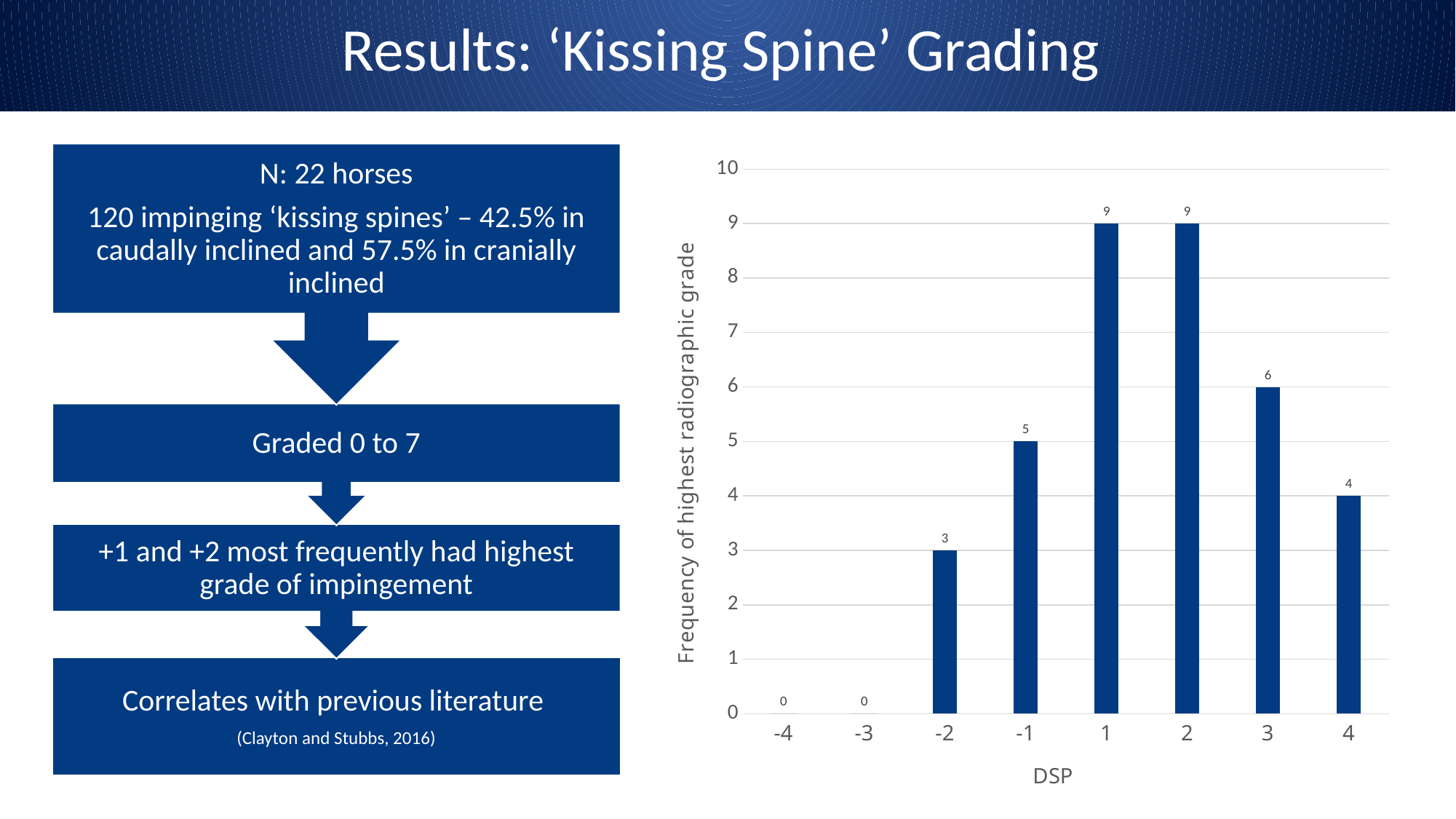
What is the label of the x axis? DSP What is the difference between the frequency for DSP 3 and the frequency for DSP -1? 1 What is the frequency of highest radiographic grade for DSP -2? 3 What is the frequency of highest radiographic grade for DSP 1? 9 Which is larger, the frequency for DSP -1 or the frequency for DSP 4? DSP -1 What is the difference between the frequency for DSP 2 and the frequency for DSP 4? 5 What is the frequency of highest radiographic grade for DSP -4? 0 What is the label of the y axis? Frequency of highest radiographic grade How many DSP categories are shown on the x axis? 8 What is the frequency of highest radiographic grade for DSP 3? 6 What kind of chart is shown on the slide? Bar chart Which DSP category has the lowest non-zero frequency? -2